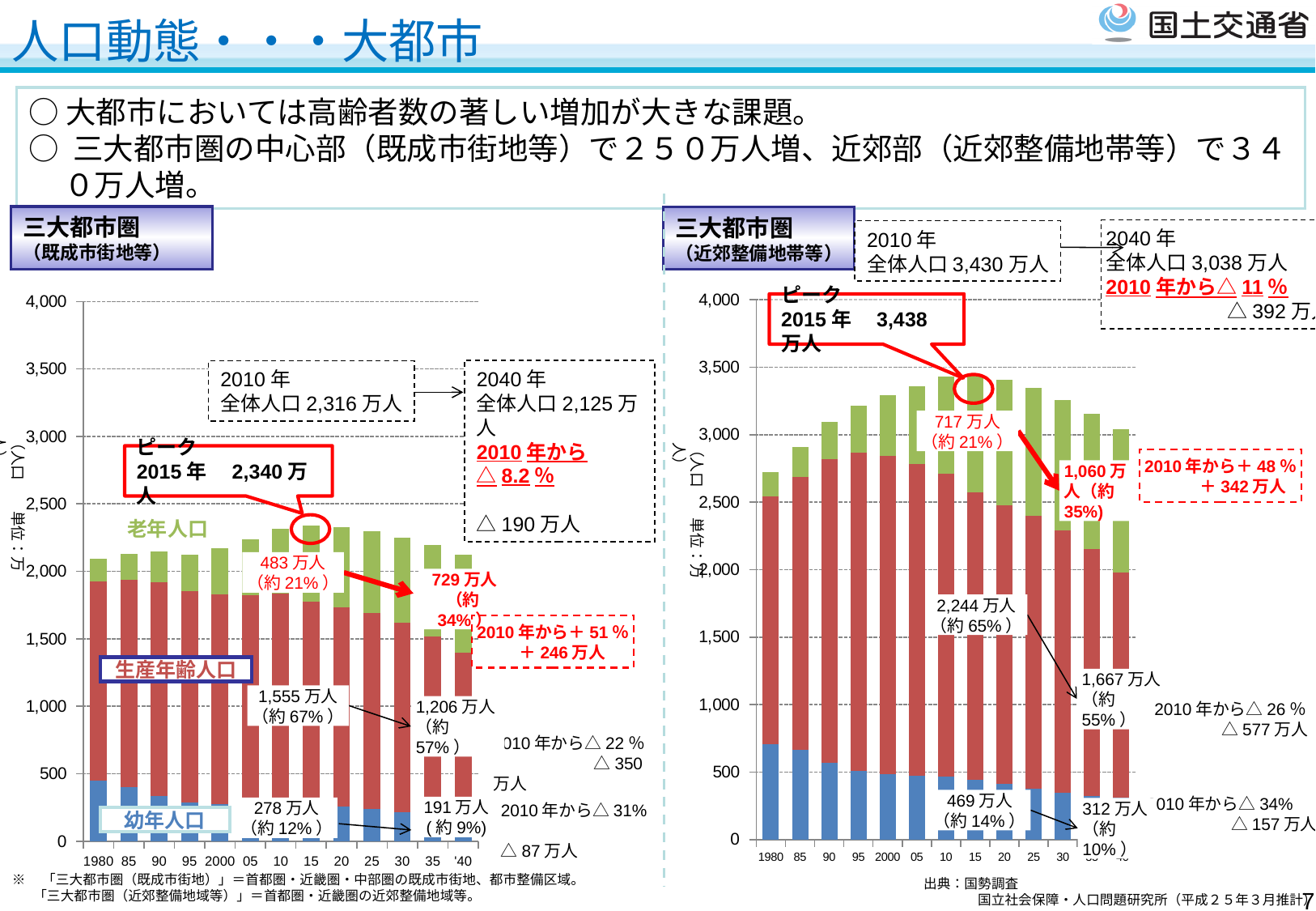
In the right chart (近郊整備地帯等), what is the 幼年人口 value for 2010? 469万人 In the right chart (近郊整備地帯等), is the total population for 1980 greater or less than 3,000? less In the right chart (近郊整備地帯等), does the total population rise or fall from 2015 to 2040? fall In the right chart (近郊整備地帯等), what is the total population for 2040? 3,038万人 In the left chart (既成市街地等), what is the peak total population and in which year does it occur? 2,340万人 in 2015 In the left chart (既成市街地等), which is larger: the 2010 total population (2,316万人) or the 2040 total population (2,125万人)? 2010 total population (2,316万人) In the left chart (既成市街地等), what is the 老年人口 value for 2010? 483万人 In the left chart (既成市街地等), what is the 生産年齢人口 value for 2040? 1,206万人 In the right chart (近郊整備地帯等), by how much does the 老年人口 increase from 2010 (717万人) to 2040 (1,060万人)? 342万人 How many year categories (bars) are plotted in the left chart (既成市街地等)? 13 What kind of chart is used on the left (三大都市圏（既成市街地等）) side of the slide? Stacked bar chart How many population groups are stacked in each bar of the left chart (既成市街地等)? 3